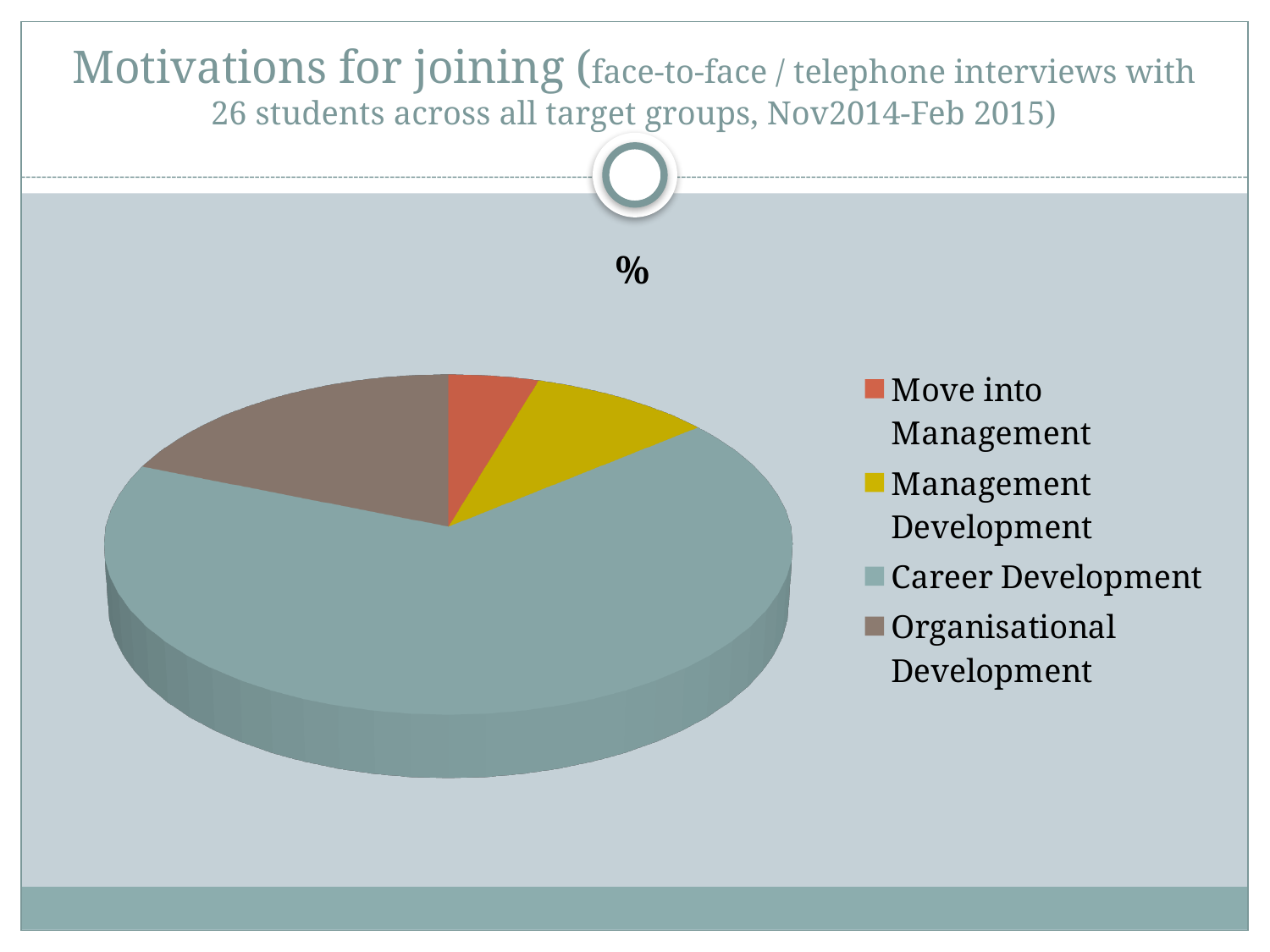
What is the title shown above the pie chart? % Which category has the smallest slice of the pie chart? Move into Management What kind of chart is shown on the slide? Pie chart How many slices does the pie chart have? 4 Which slice is larger, Management Development or Move into Management? Management Development What colour is the Career Development slice in the pie chart? Teal Which slice is larger, Organisational Development or Management Development? Organisational Development How many entries does the legend of the pie chart list? 4 Which slice is larger, Career Development or Organisational Development? Career Development Which category has the largest slice of the pie chart? Career Development